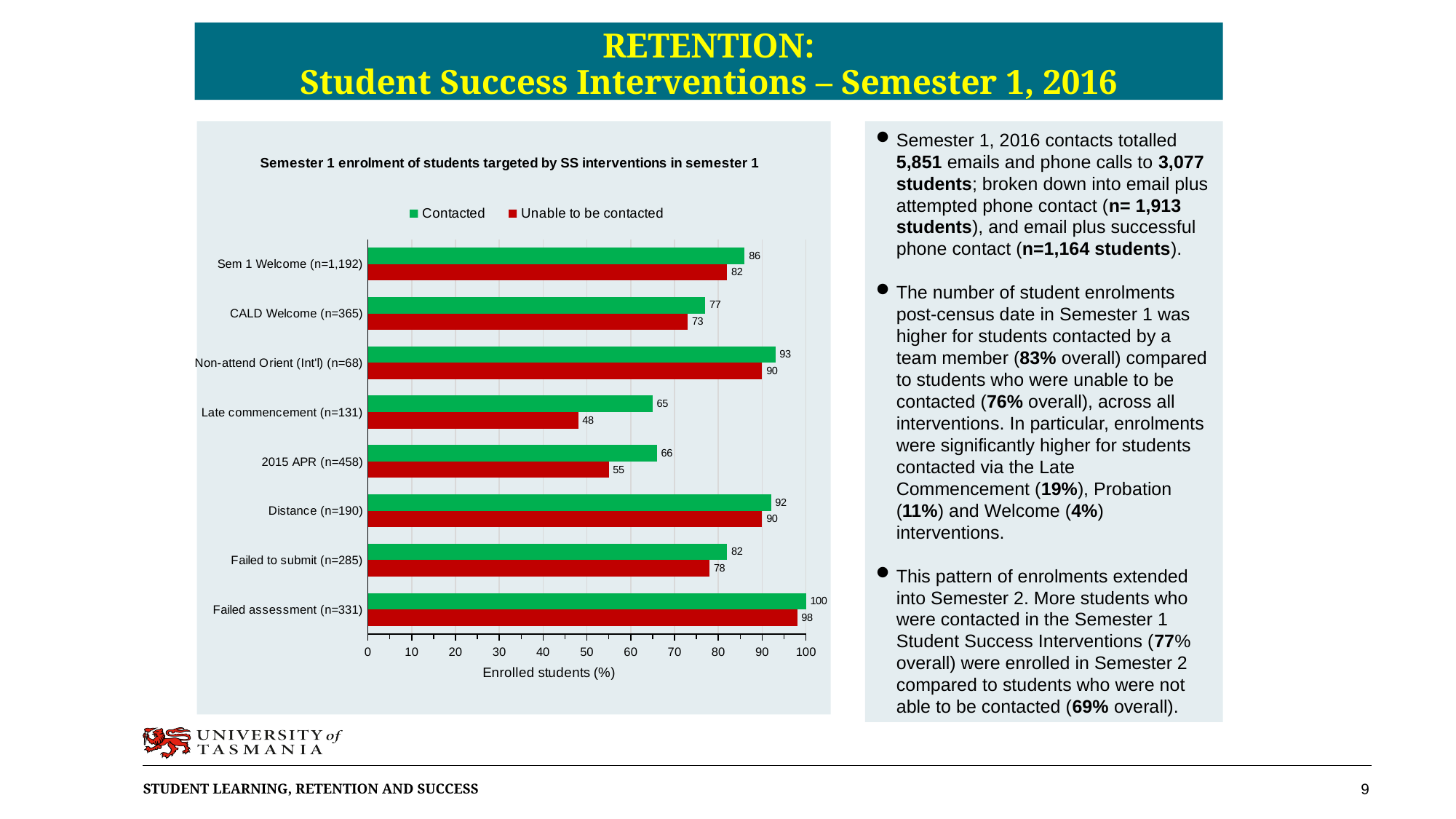
Which is larger: the Contacted value for Distance (n=190) or the Contacted value for Sem 1 Welcome (n=1,192)? Distance (n=190) What colour represents the Unable to be contacted series? red What is the Unable to be contacted value for 2015 APR (n=458)? 55 What is the x-axis label of the chart? Enrolled students (%) How many series does the legend list? 2 Is the Unable to be contacted value for CALD Welcome (n=365) greater or less than 80? less What kind of chart is shown on the slide? bar chart How many categories are shown on the chart? 8 What is the Contacted value for Late commencement (n=131)? 65 Which category has the lowest Unable to be contacted value? Late commencement (n=131) What is the difference between the Contacted and Unable to be contacted values for Late commencement (n=131)? 17 Which category has the highest Contacted value? Failed assessment (n=331)